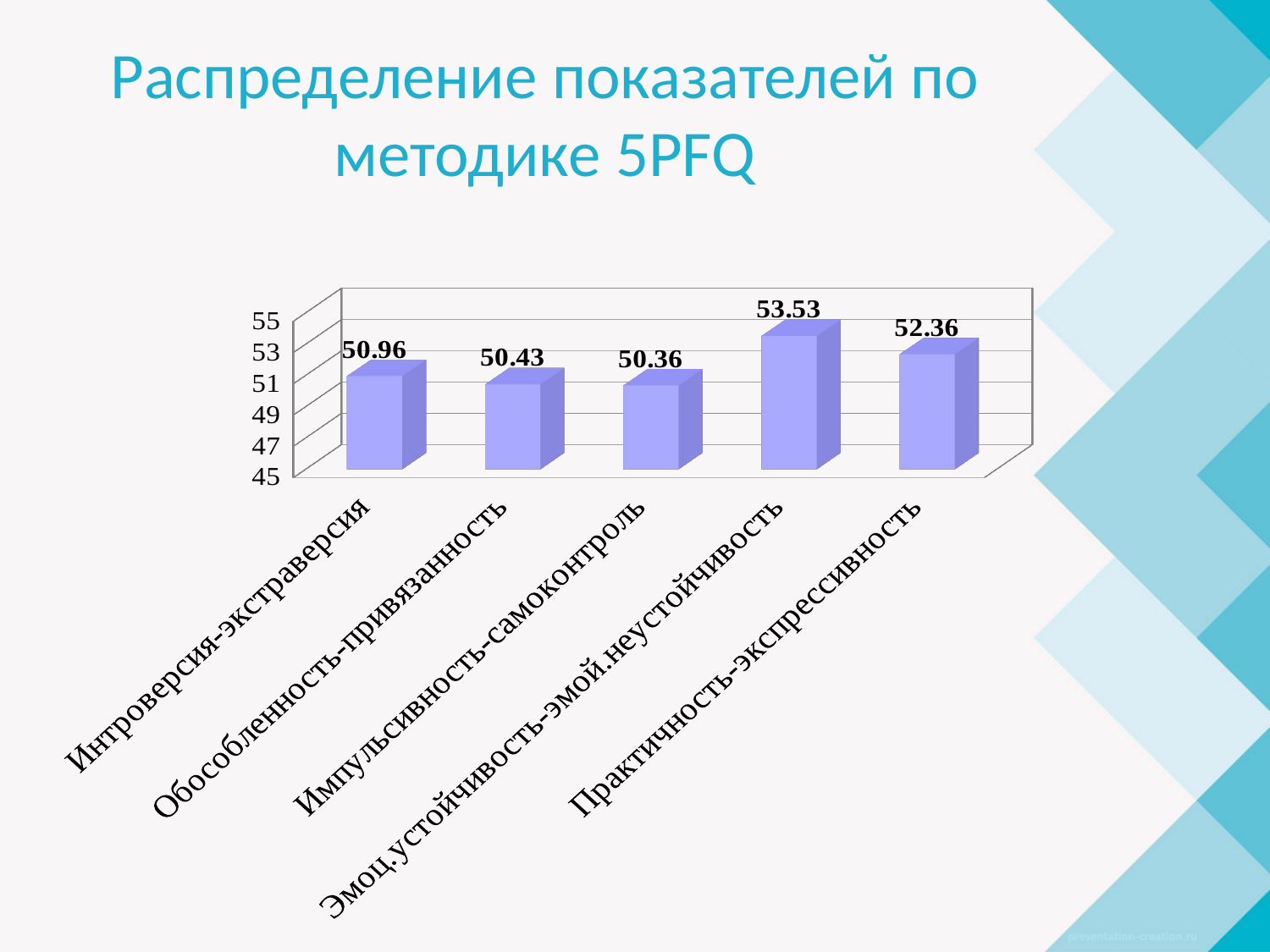
What is the value for Обособленность-привязанность? 50.43 What is the value for Практичность-экспрессивность? 52.36 Which category has the lowest value? Импульсивность-самоконтроль What kind of chart is shown on the slide? Bar chart What is the value for Эмоц.устойчивость-эмой.неустойчивость? 53.53 Which category has the highest value? Эмоц.устойчивость-эмой.неустойчивость How many categories are shown in the chart? 5 What is the value for Интроверсия-экстраверсия? 50.96 Which is larger, the value for Интроверсия-экстраверсия or the value for Практичность-экспрессивность? Практичность-экспрессивность What is the difference between the values for Эмоц.устойчивость-эмой.неустойчивость and Практичность-экспрессивность? 1.17 What is the value for Импульсивность-самоконтроль? 50.36 What is the title of the slide? Распределение показателей по методике 5PFQ